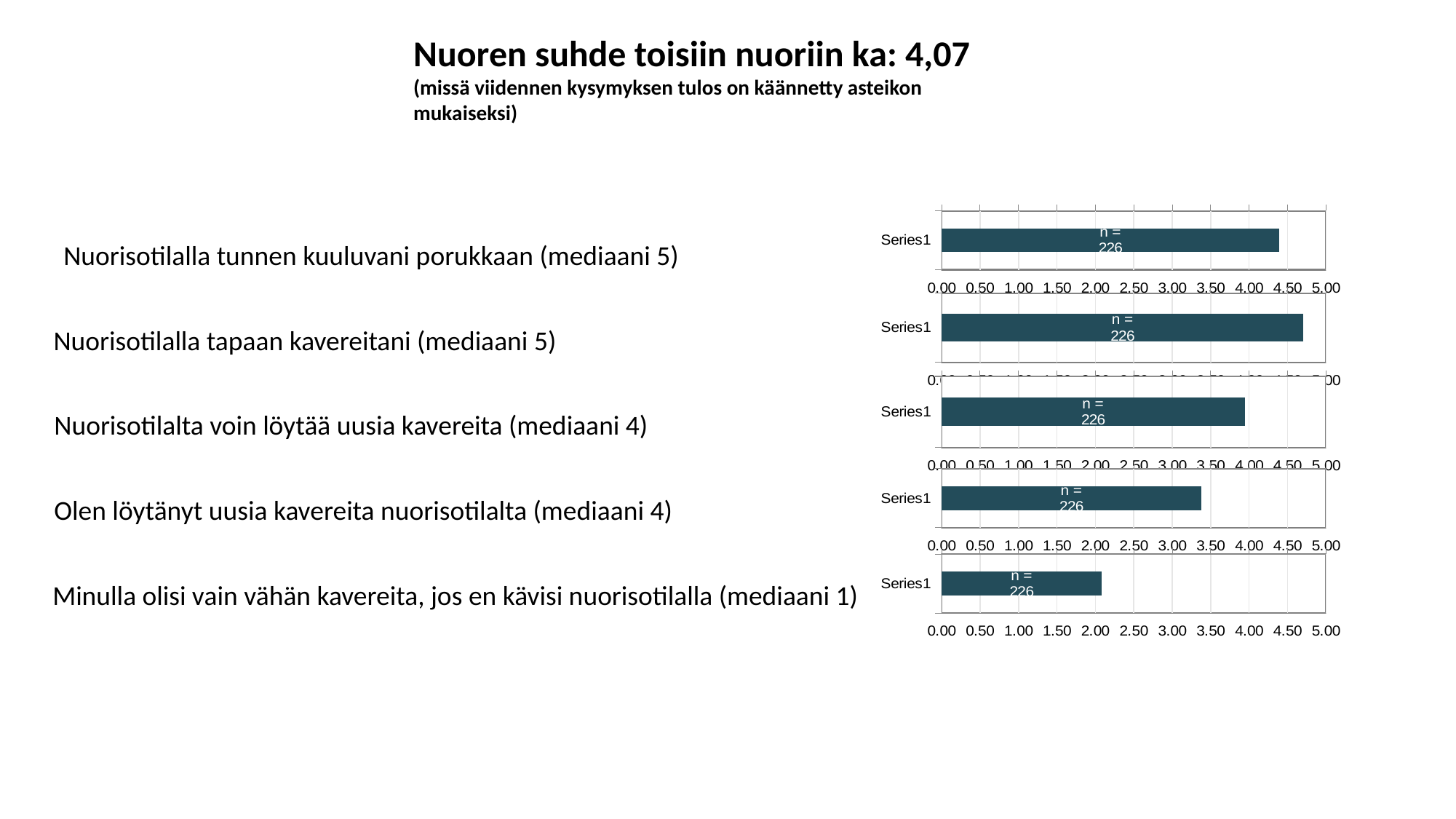
What kind of chart is the top chart on the slide? bar chart In the top chart (next to 'Nuorisotilalla tunnen kuuluvani porukkaan'), is the value of the bar greater or less than 4.00? greater In the bottom chart (next to 'Minulla olisi vain vähän kavereita, jos en kävisi nuorisotilalla'), is the value of the bar greater or less than 2.50? less What data label is printed on the bar in the bottom chart? n = 226 In the third chart from the top (next to 'Nuorisotilalta voin löytää uusia kavereita'), is the value of the bar greater or less than 3.50? greater What is the highest value shown on the x axis of the bottom chart? 5.00 How many bars does the top chart on the slide show? 1 Which of the five charts on the slide has the longest bar? the second chart from the top (Nuorisotilalla tapaan kavereitani) Which of the five charts on the slide has the shortest bar? the bottom chart (Minulla olisi vain vähän kavereita, jos en kävisi nuorisotilalla) Is the bar in the second chart from the top longer or shorter than the bar in the bottom chart? longer